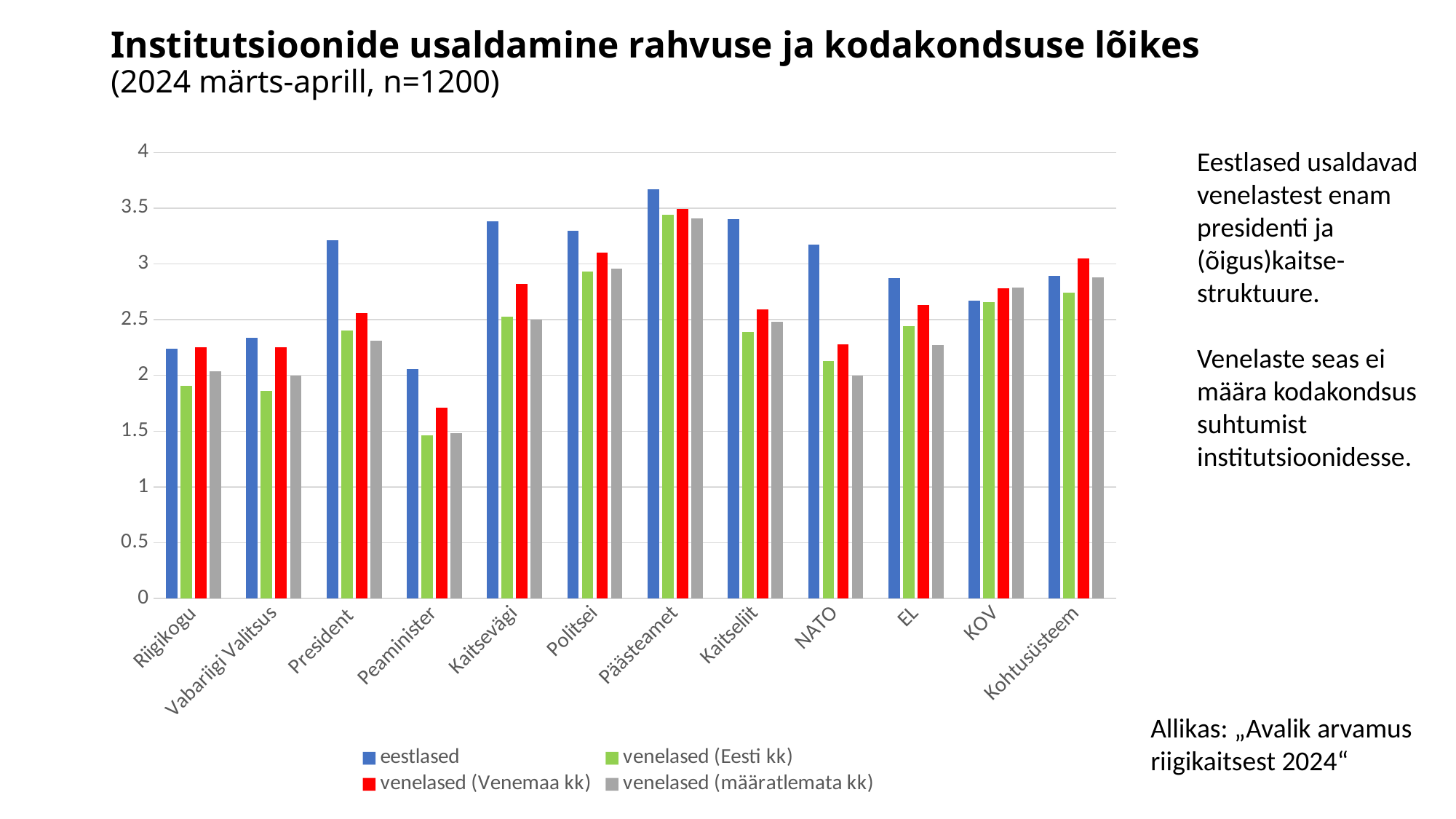
What kind of chart is shown on the slide? bar chart For which institution is the value for venelased (Venemaa kk) the highest? Päästeamet For NATO, which is larger: the value for eestlased or the value for venelased (Eesti kk)? eestlased For which institution is the value for venelased (Eesti kk) the lowest? Peaminister Is the value for venelased (määratlemata kk) for NATO greater or less than 2.5? less How many institutions (categories) are shown on the x axis of the chart? 12 Which colour represents the series eestlased in the chart? blue For which institution is the value for eestlased the lowest? Peaminister Is the value for eestlased for Päästeamet greater or less than 3.5? greater How many series does the chart's legend list? 4 For which institution is the value for eestlased the highest? Päästeamet Is the value for eestlased for President greater or less than 3? greater